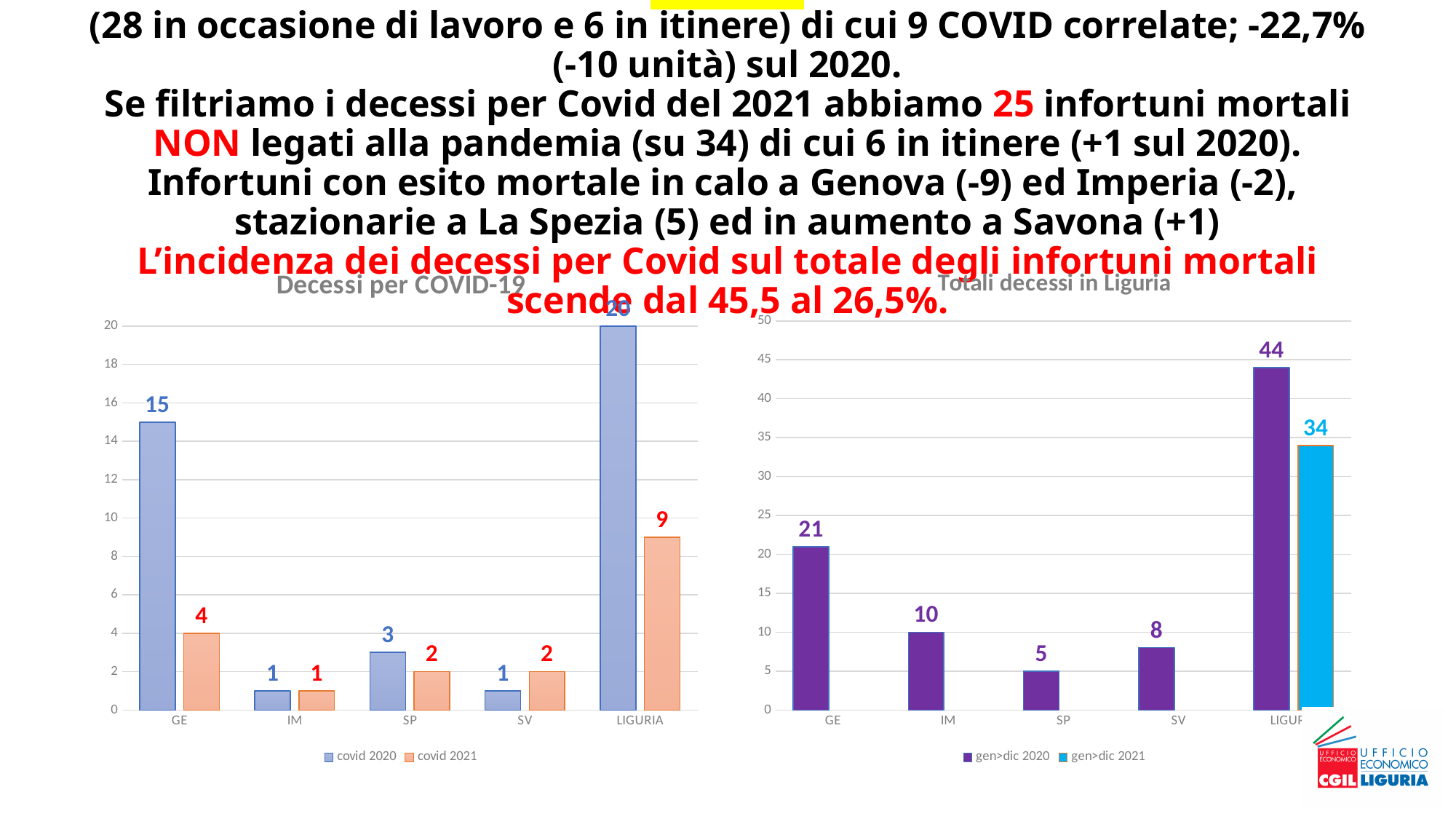
In the right chart (Totali decessi in Liguria), what is the gen>dic 2020 value for SP? 5 In the left chart (Decessi per COVID-19), what is the covid 2020 value for GE? 15 In the left chart (Decessi per COVID-19), which category has the highest covid 2021 value? LIGURIA What type of chart is the right chart (Totali decessi in Liguria)? bar chart In the left chart (Decessi per COVID-19), what is the covid 2021 value for SV? 2 In the left chart (Decessi per COVID-19), how many series does the legend list? 2 In the left chart (Decessi per COVID-19), what is the covid 2021 value for LIGURIA? 9 In the right chart (Totali decessi in Liguria), what is the gen>dic 2020 value for GE? 21 In the right chart (Totali decessi in Liguria), what is the difference between the gen>dic 2020 and gen>dic 2021 values for the last category (Liguria)? 10 In the right chart (Totali decessi in Liguria), is the gen>dic 2020 value for IM larger or smaller than the value for SV? larger In the left chart (Decessi per COVID-19), what is the difference between the covid 2020 and covid 2021 values for GE? 11 In the right chart (Totali decessi in Liguria), which category has the lowest gen>dic 2020 value? SP